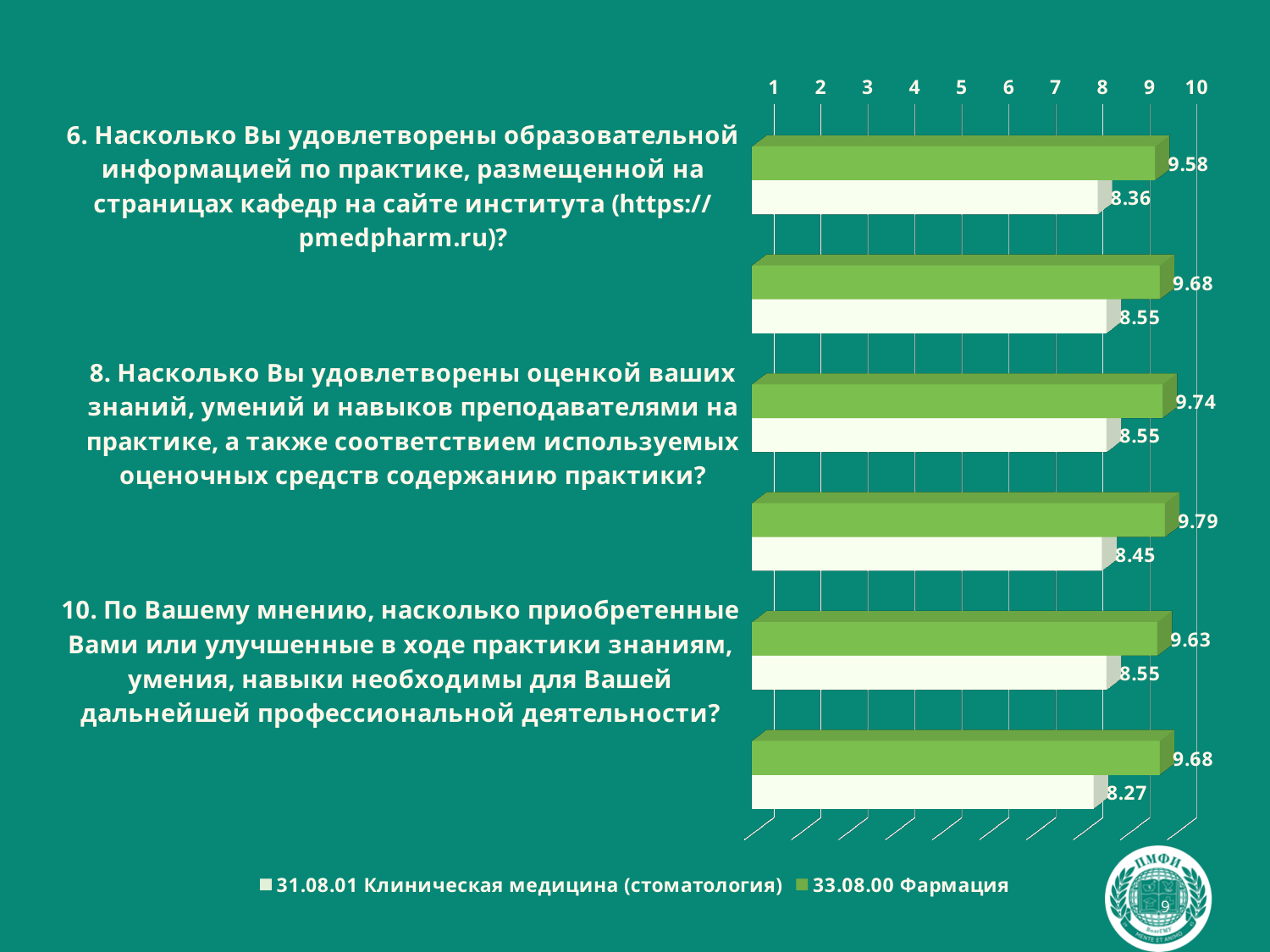
On question 10, which series has the larger value: 33.08.00 Фармация or 31.08.01 Клиническая медицина (стоматология)? 33.08.00 Фармация How many pairs of bars (category groups) are plotted in the chart? 6 What kind of chart is shown on the slide? bar chart What is the difference between the 33.08.00 Фармация and 31.08.01 Клиническая медицина (стоматология) values on question 6? 1.22 What is the highest value shown for the 33.08.00 Фармация series? 9.79 What value is shown for 31.08.01 Клиническая медицина (стоматология) on question 6? 8.36 What value is shown for 31.08.01 Клиническая медицина (стоматология) on question 10 (necessity of acquired knowledge for future professional activity)? 8.55 What is the lowest value shown for the 31.08.01 Клиническая медицина (стоматология) series? 8.27 What value is shown for 33.08.00 Фармация on question 8 (satisfaction with the assessment of knowledge, skills and abilities by teachers)? 9.74 What value is shown for 33.08.00 Фармация on question 6 (satisfaction with educational information about practice on the institute website)? 9.58 How many series does the legend list? 2 Is the value for 31.08.01 Клиническая медицина (стоматология) on question 8 greater or less than 9? less